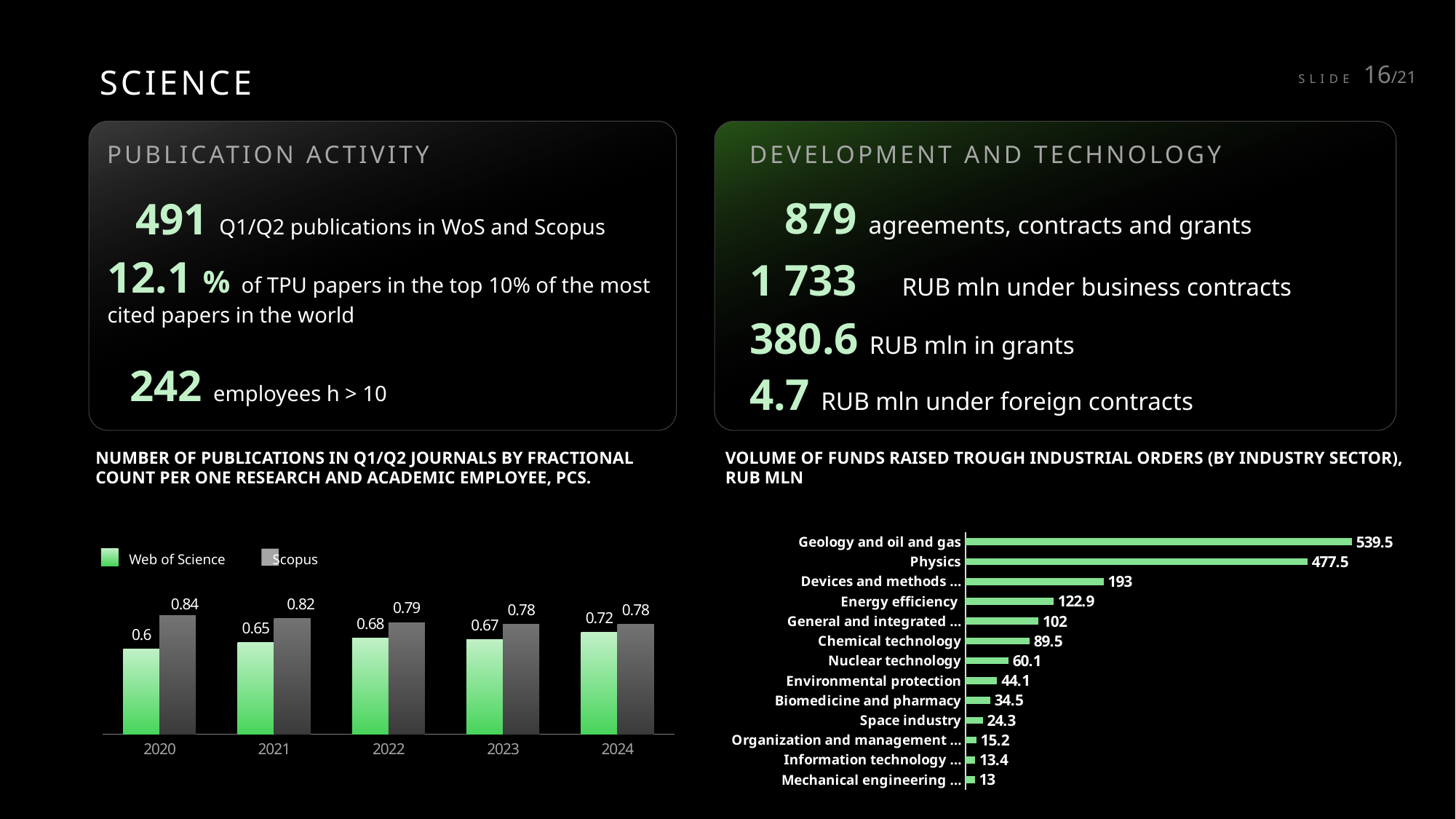
In the left chart (number of publications in Q1/Q2 journals per employee), which year has the lowest Web of Science value? 2020 In the left chart (number of publications in Q1/Q2 journals per employee), what is the Scopus value for 2020? 0.84 In the left chart (number of publications in Q1/Q2 journals per employee), does the Web of Science value rise or fall from 2020 to 2024? rise In the left chart (number of publications in Q1/Q2 journals per employee), what is the Web of Science value for 2024? 0.72 In the right chart (volume of funds raised through industrial orders), which is larger: Nuclear technology or Environmental protection? Nuclear technology In the left chart (number of publications in Q1/Q2 journals per employee), how many years are shown on the x axis? 5 In the right chart (volume of funds raised through industrial orders), which industry sector has the highest value? Geology and oil and gas In the right chart (volume of funds raised through industrial orders), what is the value for Chemical technology? 89.5 What kind of chart is the right chart (volume of funds raised through industrial orders)? bar chart In the left chart (number of publications in Q1/Q2 journals per employee), what is the difference between the Scopus and Web of Science values in 2021? 0.17 In the left chart (number of publications in Q1/Q2 journals per employee), how many series does the legend list? 2 In the right chart (volume of funds raised through industrial orders), what is the difference between Geology and oil and gas and Physics? 62